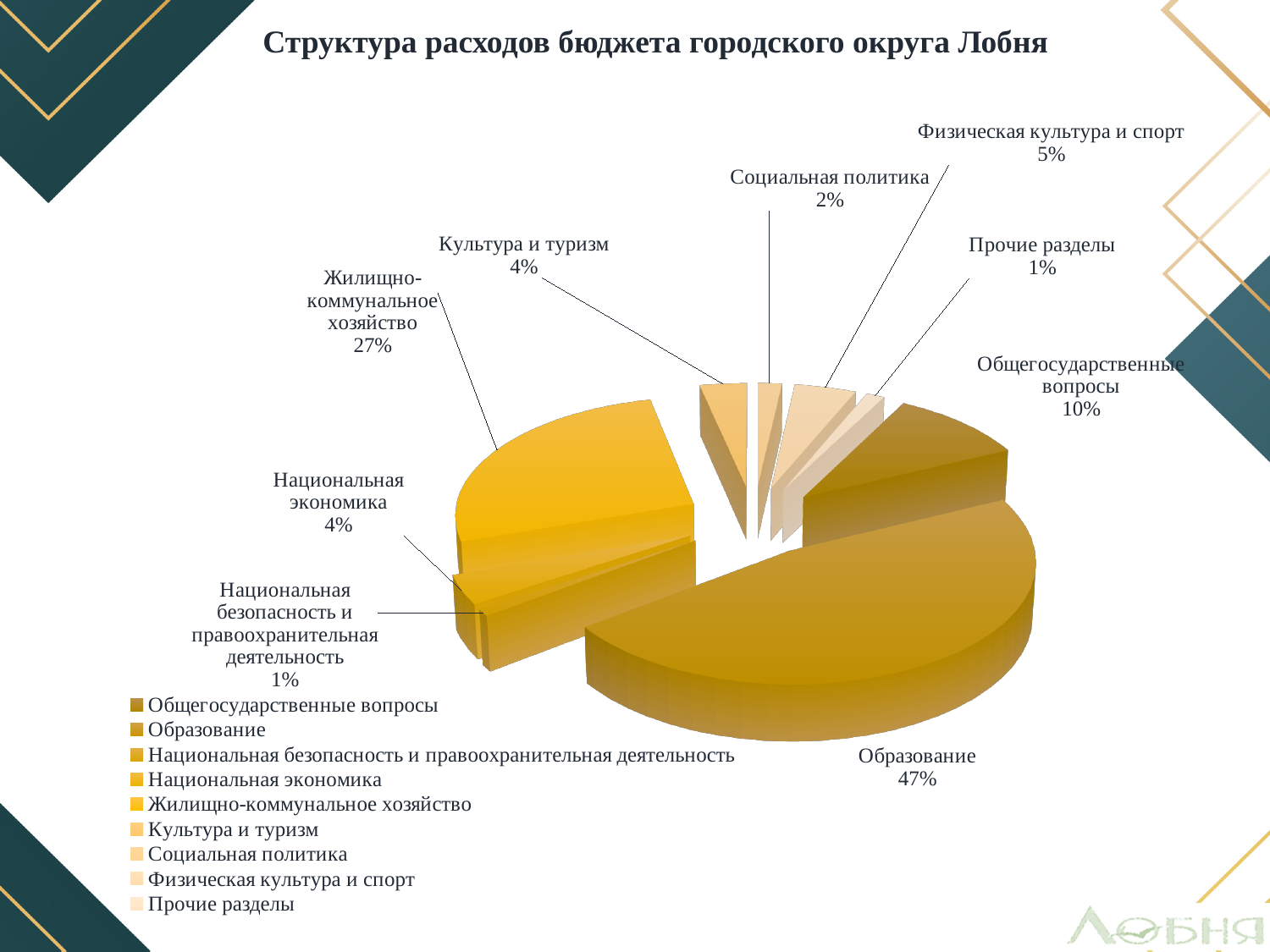
What share of the budget expenditure goes to Образование? 47% What percentage is shown for Социальная политика? 2% What share of the budget expenditure goes to Жилищно-коммунальное хозяйство? 27% What percentage is shown for Общегосударственные вопросы? 10% What type of chart is shown on the slide? pie chart What is the difference in percentage points between Культура и туризм and Социальная политика? 2 Which has a larger share: Общегосударственные вопросы or Физическая культура и спорт? Общегосударственные вопросы Which category has the largest share of the budget expenditure? Образование What is the title of the chart? Структура расходов бюджета городского округа Лобня What is the difference in percentage points between Образование and Жилищно-коммунальное хозяйство? 20 How many categories (slices) does the pie chart have? 9 What percentage is shown for Физическая культура и спорт? 5%